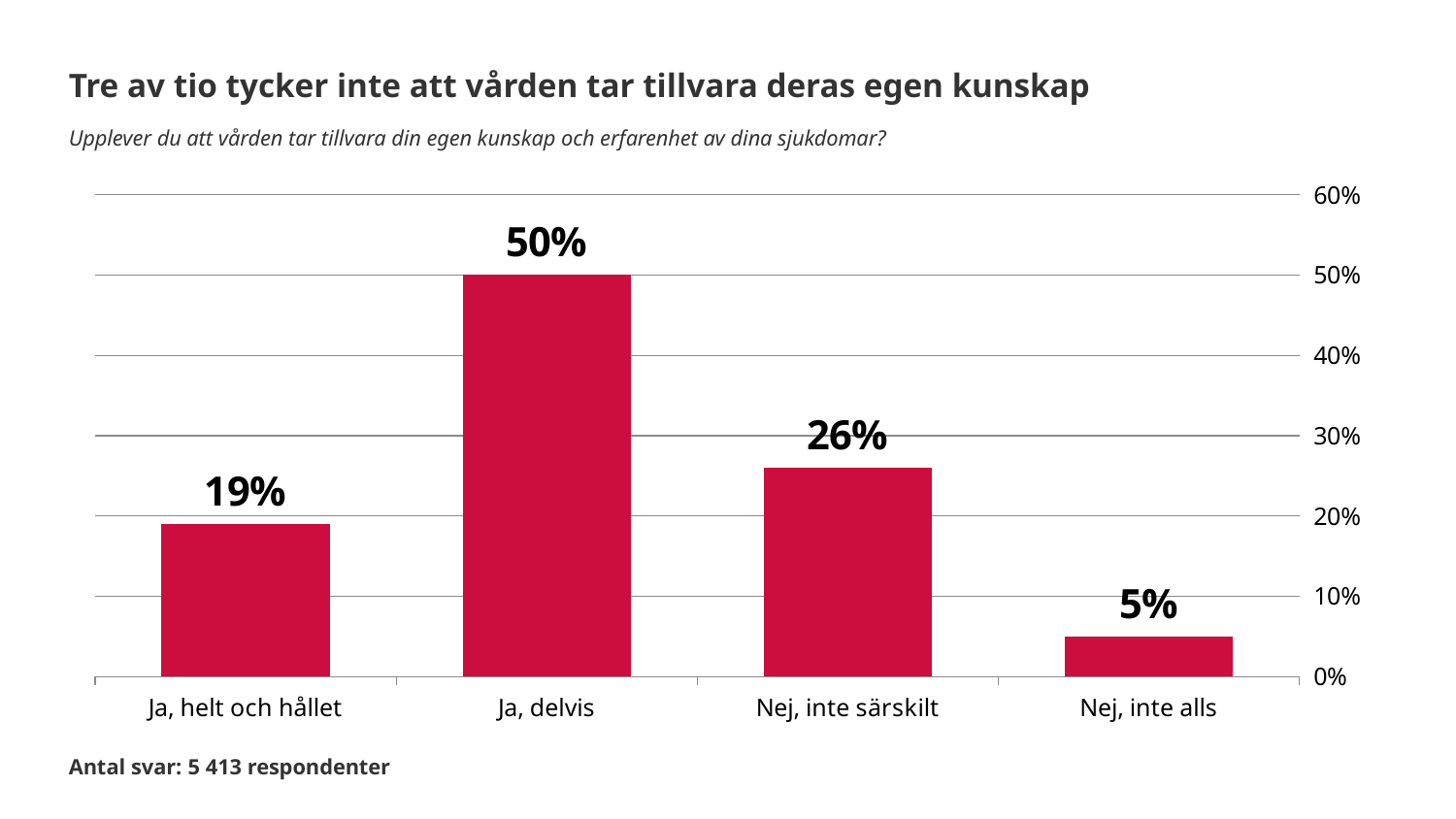
What is the value for "Nej, inte alls"? 5% Which category has the highest value? Ja, delvis How many categories are shown on the x axis? 4 What is the value for "Ja, helt och hållet"? 19% Which category has the lowest value? Nej, inte alls What kind of chart is shown on the slide? bar chart How many respondents answered, according to the note below the chart? 5 413 What is the difference between the values for "Nej, inte särskilt" and "Ja, helt och hållet"? 7% What is the title of the slide? Tre av tio tycker inte att vården tar tillvara deras egen kunskap Is the value for "Nej, inte särskilt" greater or less than 30%? less What is the value for "Ja, delvis"? 50% Which is larger, the value for "Ja, helt och hållet" or the value for "Nej, inte särskilt"? Nej, inte särskilt